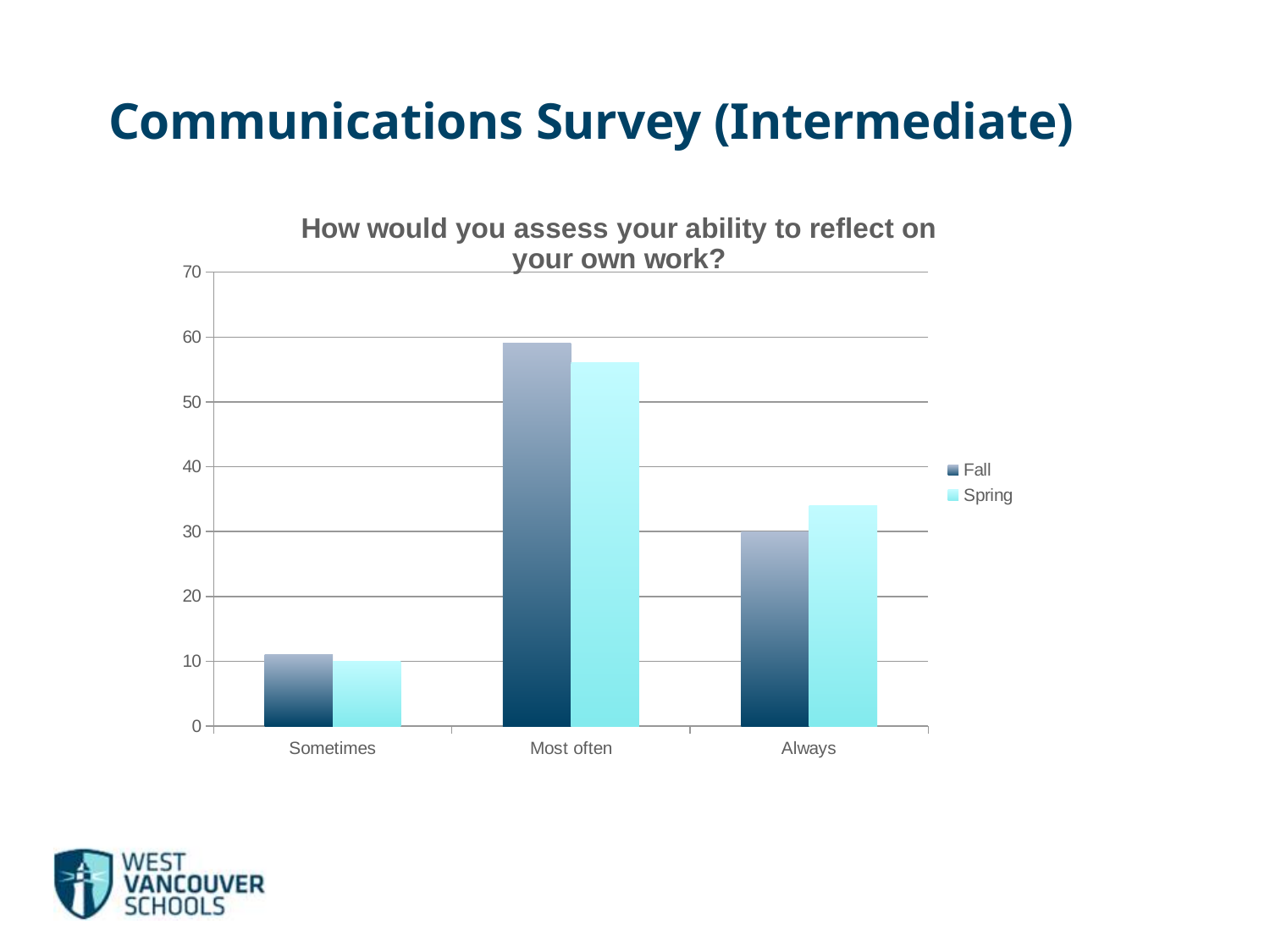
What is the title of the chart? How would you assess your ability to reflect on your own work? How many categories are shown on the x axis? 3 Which series is shown in light cyan in the legend? Spring What kind of chart is shown on the slide? bar chart Is the Fall value for Sometimes greater or less than 20? less Is the Spring value for Most often greater or less than 60? less Is the Fall value for Most often greater or less than 50? greater Which category has the highest Fall value? Most often Which category has the lowest Spring value? Sometimes For Always, which series has the larger value, Fall or Spring? Spring For Most often, which series has the larger value, Fall or Spring? Fall How many series does the legend list? 2